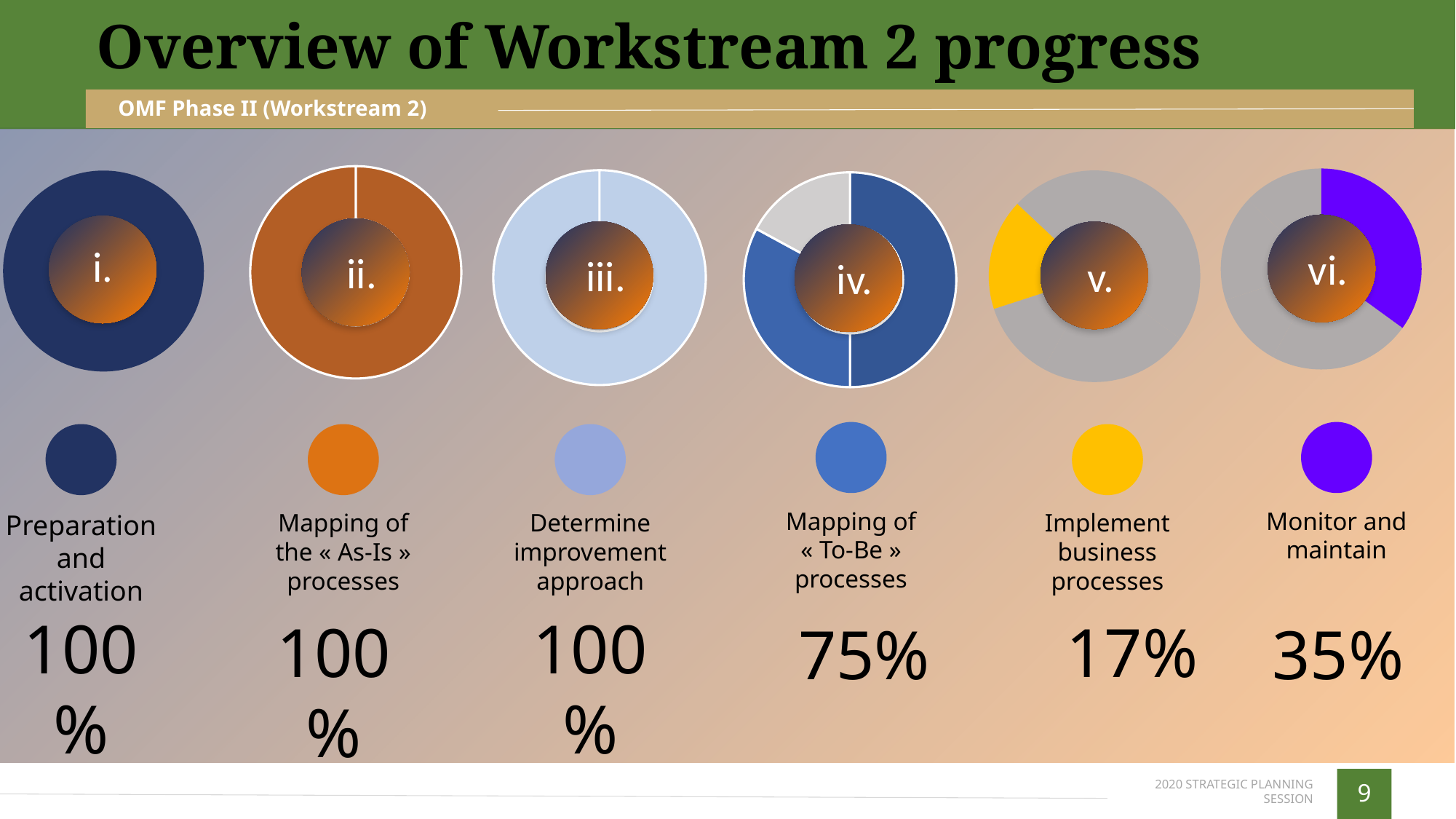
What colour is the legend marker for chart vi., Monitor and maintain? Purple What is the progress value shown for chart v., Implement business processes? 17% Which has a larger progress value: chart v. (Implement business processes) or chart vi. (Monitor and maintain)? Monitor and maintain How many workstream steps are shown with progress charts on the slide? 6 What kind of chart is used to show the progress of each workstream step? Donut chart What is the progress value shown for chart i., Preparation and activation? 100% Which workstream step has the lowest progress value on the slide? Implement business processes What is the progress value shown for chart iv., Mapping of « To-Be » processes? 75% How many of the workstream steps show 100% progress? 3 What is the progress value shown for chart vi., Monitor and maintain? 35% What is the difference between the progress values for chart vi. (Monitor and maintain) and chart v. (Implement business processes)? 18% What is the difference between the progress values for chart iv. (Mapping of « To-Be » processes) and chart vi. (Monitor and maintain)? 40%